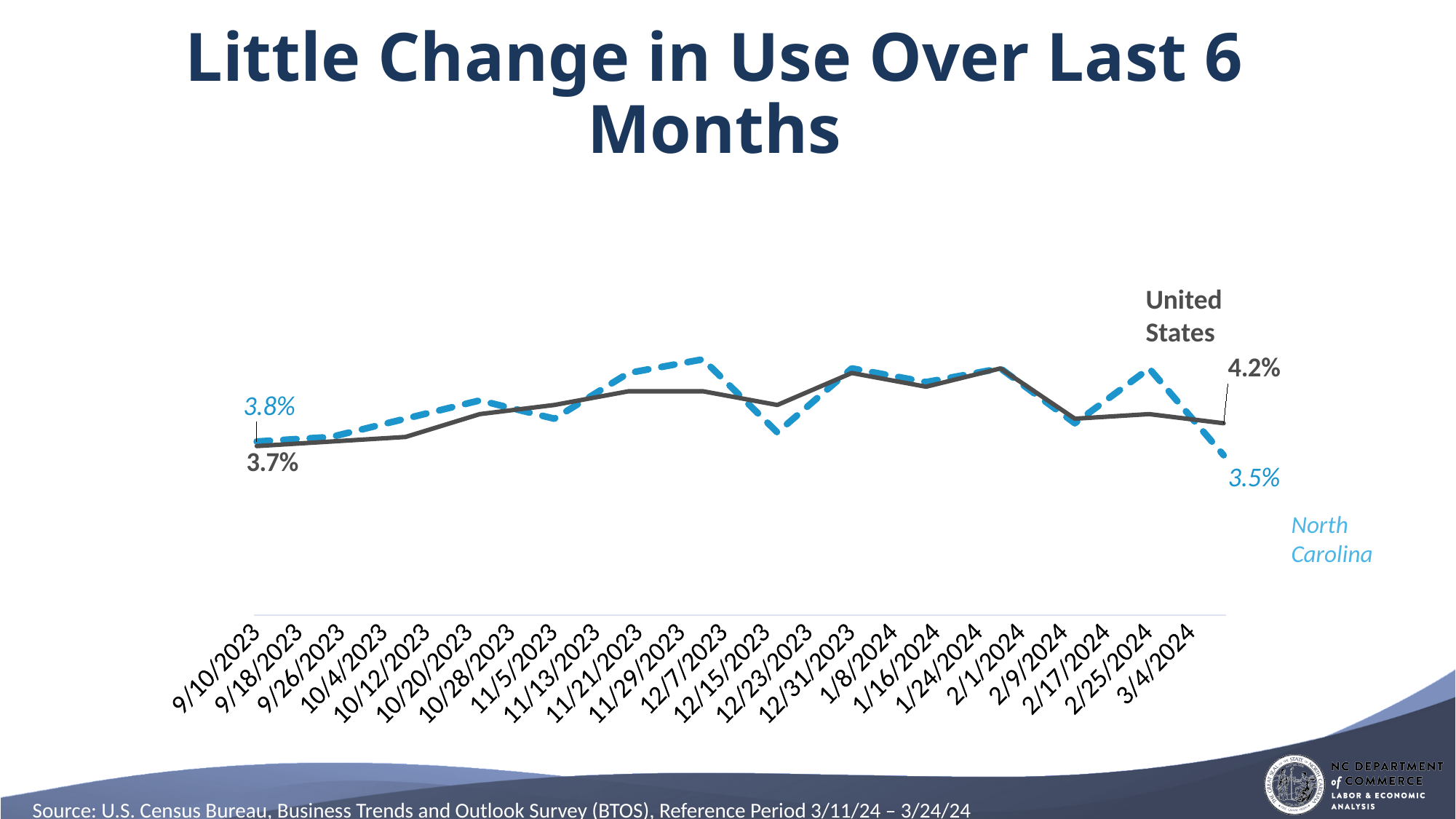
What is the value for the United States on 3/4/2024? 4.2% Which series is drawn as a dashed blue line? North Carolina What is the value for North Carolina on 9/10/2023? 3.8% What type of chart is shown on the slide? Line chart How many series are plotted on the chart? 2 What is the title of the chart on the slide? Little Change in Use Over Last 6 Months On 3/4/2024, which series has the higher value, United States or North Carolina? United States How many dates are shown on the x axis? 23 By how many percentage points did the United States value change from 9/10/2023 to 3/4/2024? 0.5 percentage points What is the value for North Carolina on 3/4/2024? 3.5% What is the difference between the United States and North Carolina values on 3/4/2024? 0.7 percentage points What is the value for the United States on 9/10/2023? 3.7%